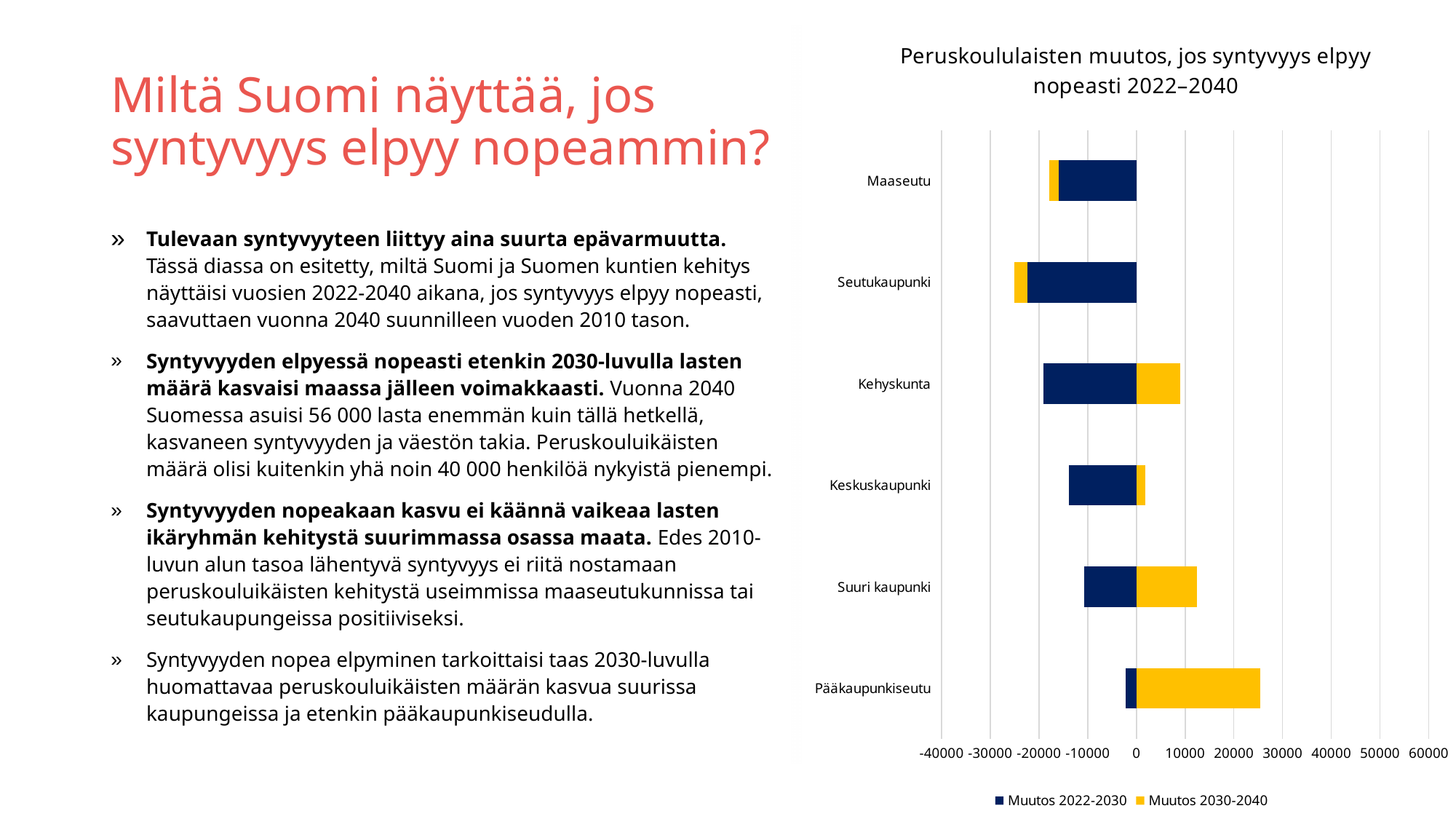
Which has the larger Muutos 2030-2040 value, Pääkaupunkiseutu or Suuri kaupunki? Pääkaupunkiseutu Is the Muutos 2030-2040 value for Pääkaupunkiseutu greater or less than 20000? greater Which category has the lowest value for Muutos 2022-2030? Seutukaupunki Which category has the highest value for Muutos 2030-2040? Pääkaupunkiseutu Is the Muutos 2022-2030 value for Maaseutu greater or less than -10000? less Which has the larger Muutos 2022-2030 value, Maaseutu or Seutukaupunki? Maaseutu Is the Muutos 2022-2030 value for Seutukaupunki greater or less than -20000? less What is the title of the chart? Peruskoululaisten muutos, jos syntyvyys elpyy nopeasti 2022–2040 How many series does the chart legend list? 2 How many categories are shown on the chart? 6 What kind of chart is shown on the slide? Bar chart Which series is shown in yellow in the chart? Muutos 2030-2040